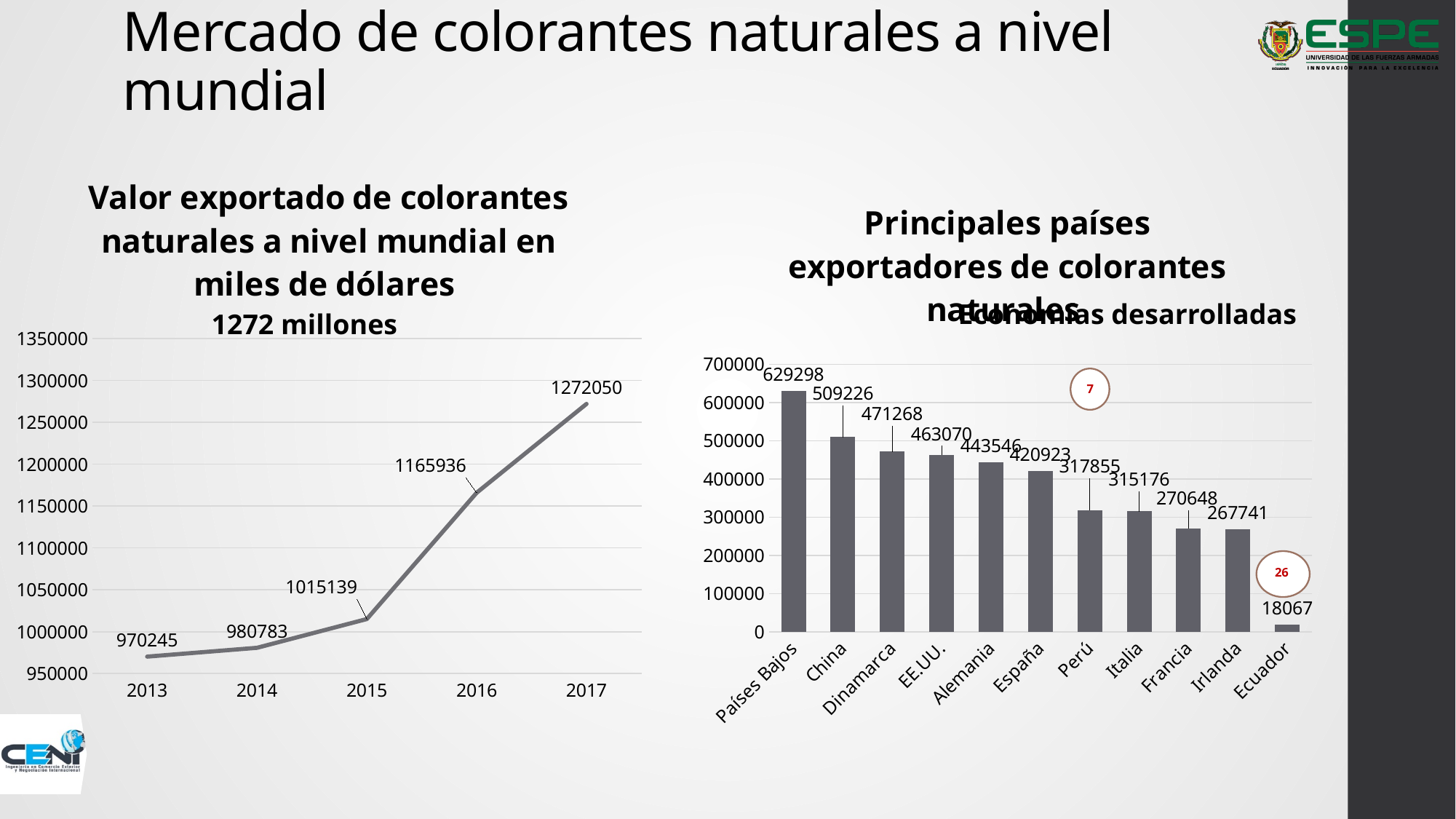
In the right chart (Principales países exportadores), what is the difference between the values for Países Bajos and China? 120072 In the left chart (Valor exportado de colorantes naturales), what is the value for 2017? 1272050 In the right chart (Principales países exportadores), how many countries are shown? 11 In the left chart (Valor exportado de colorantes naturales), what is the difference between the 2017 and 2016 values? 106114 In the right chart (Principales países exportadores), which country has the lowest value? Ecuador In the left chart (Valor exportado de colorantes naturales), what kind of chart is shown? Line chart In the left chart (Valor exportado de colorantes naturales), how many years are plotted? 5 In the right chart (Principales países exportadores), what is the value for China? 509226 In the right chart (Principales países exportadores), which country has the highest value? Países Bajos In the left chart (Valor exportado de colorantes naturales), do the values rise or fall from 2013 to 2017? Rise In the left chart (Valor exportado de colorantes naturales), what is the value for 2015? 1015139 In the right chart (Principales países exportadores), which is larger, the value for Perú or the value for Francia? Perú